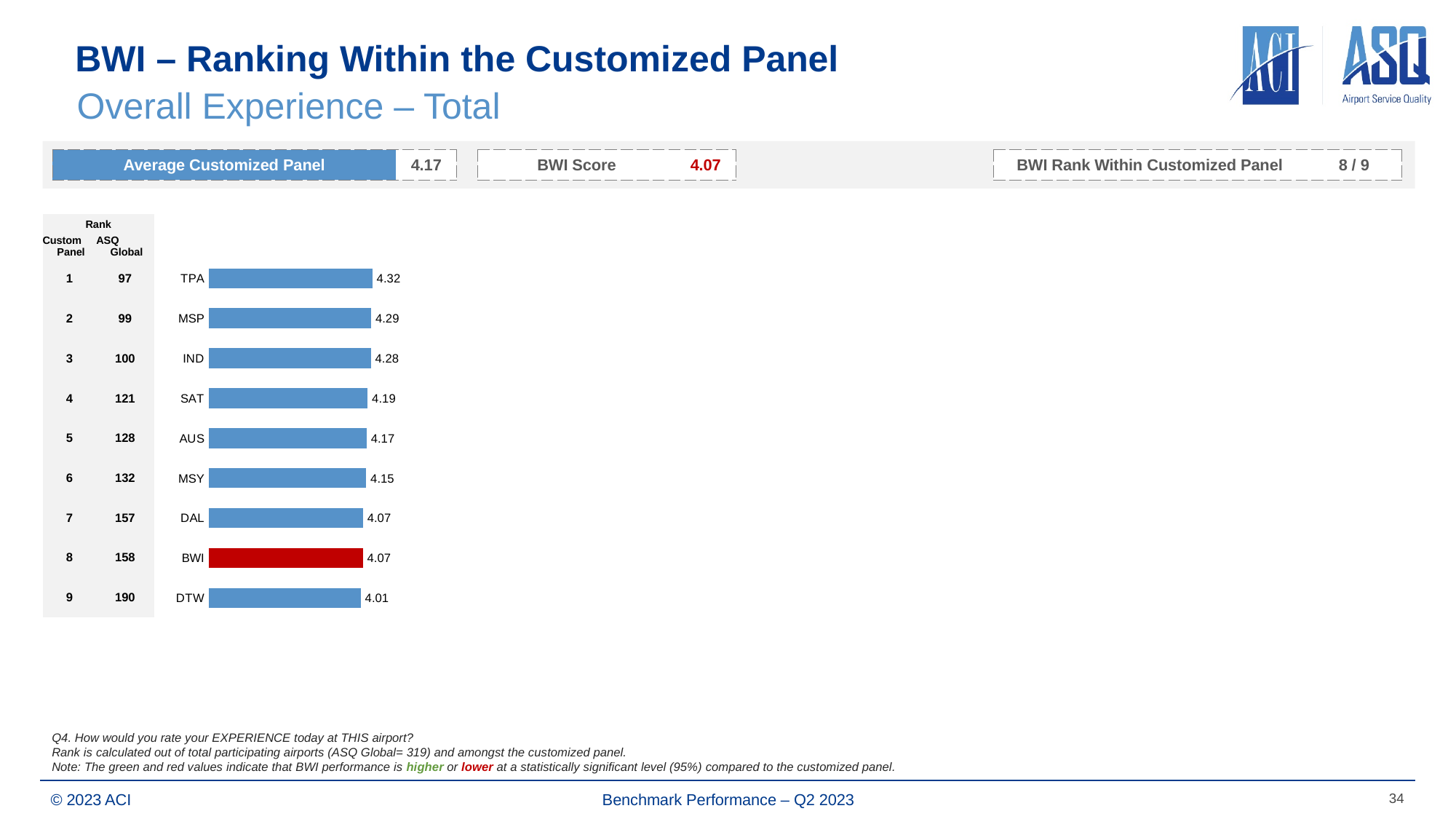
Which has a larger value, IND or MSY? IND Which airport has the lowest value? DTW Which airport has the highest value? TPA What is the value for SAT? 4.19 What kind of chart is shown on the slide? Bar chart What is the value for BWI? 4.07 What is the difference between the values for MSP and BWI? 0.22 What is the difference between the values for TPA and DTW? 0.31 What is the value for TPA? 4.32 How many airports are shown in the chart? 9 What is the value for DTW? 4.01 Which airport's bar is coloured red? BWI